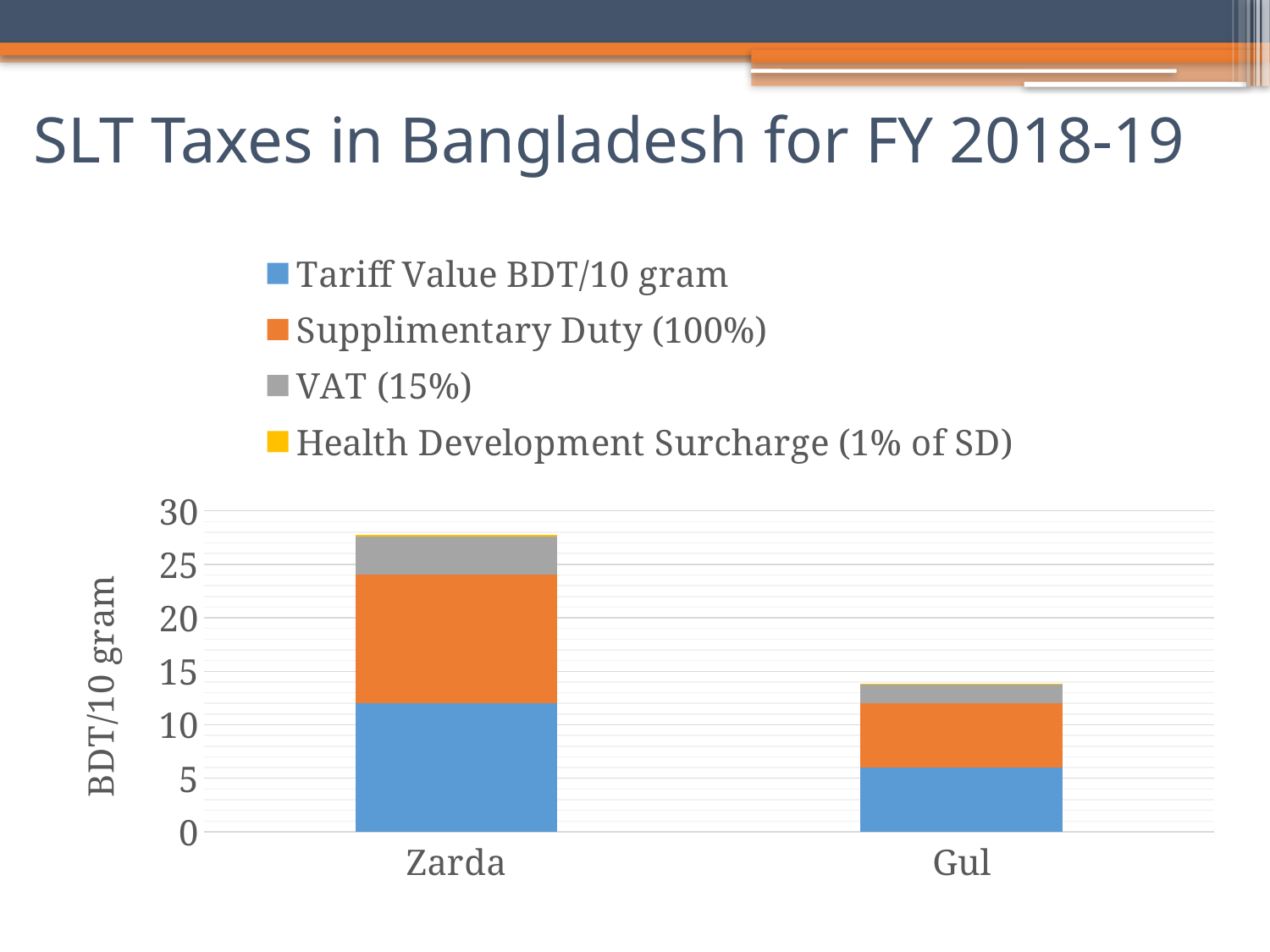
Is the total stacked bar for Zarda greater or less than 25? greater Which category has the larger Supplimentary Duty (100%) segment, Zarda or Gul? Zarda What kind of chart is shown on the slide? stacked bar chart Is the Tariff Value BDT/10 gram segment for Gul greater or less than 10? less Which category has the lowest total stacked bar? Gul How many series does the legend list? 4 What is the label on the vertical axis? BDT/10 gram Is the Tariff Value BDT/10 gram segment for Zarda greater or less than 10? greater Which category has the taller stacked bar, Zarda or Gul? Zarda Which series is shown in orange in the legend? Supplimentary Duty (100%) How many categories are shown on the x axis? 2